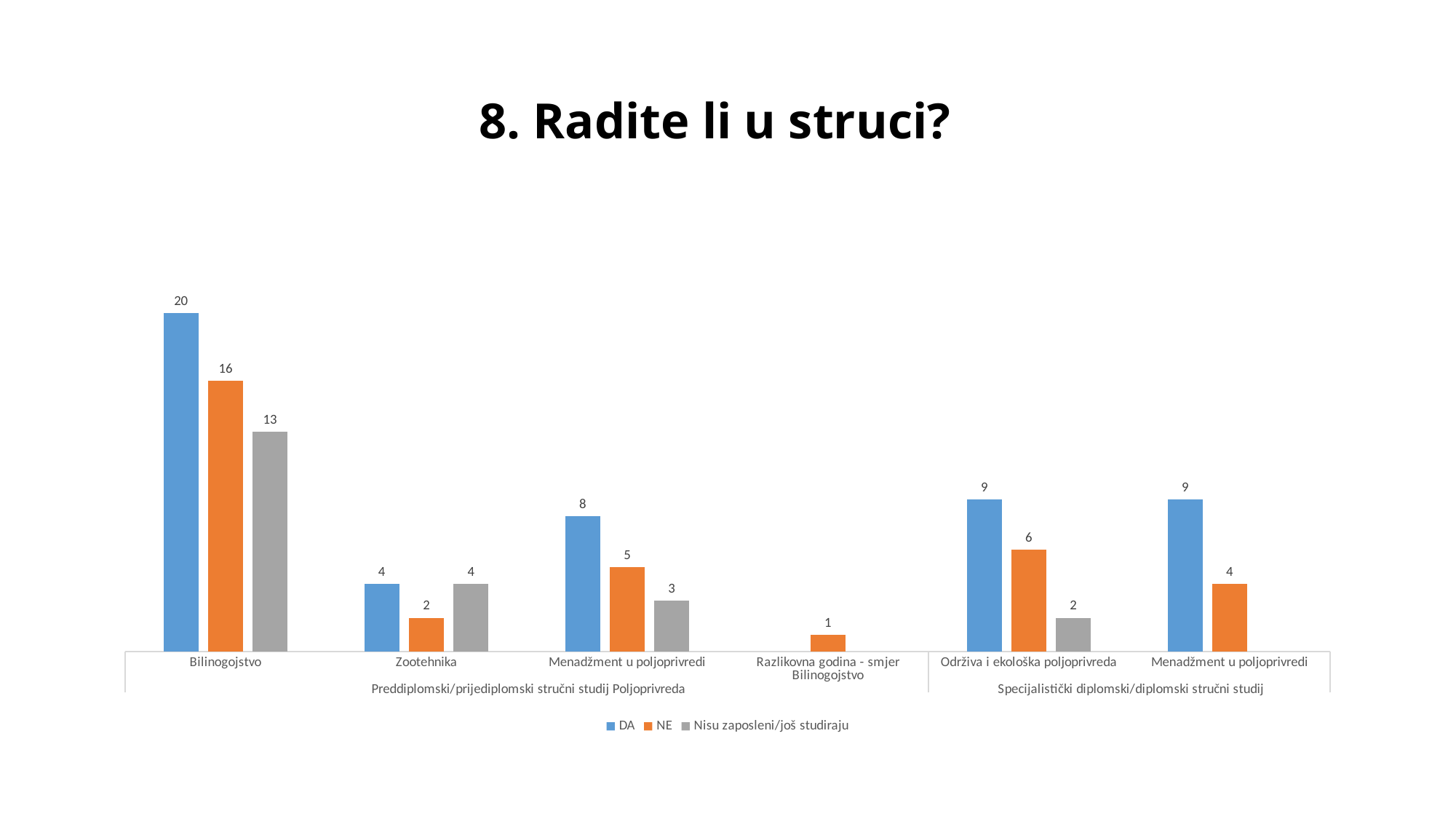
What is the DA value for Bilinogojstvo? 20 Which category has the lowest NE value? Razlikovna godina - smjer Bilinogojstvo How many categories are shown on the x axis? 6 Which category has the highest DA value? Bilinogojstvo What is the 'Nisu zaposleni/još studiraju' value for Održiva i ekološka poljoprivreda? 2 Which is larger for Menadžment u poljoprivredi in the Preddiplomski/prijediplomski stručni studij Poljoprivreda group: the DA value or the NE value? DA What is the NE value for Zootehnika? 2 What is the NE value for Razlikovna godina - smjer Bilinogojstvo? 1 What is the title of the chart? 8. Radite li u struci? How many series does the legend list? 3 What kind of chart is shown on the slide? bar chart What is the difference between the DA and NE values for Bilinogojstvo? 4